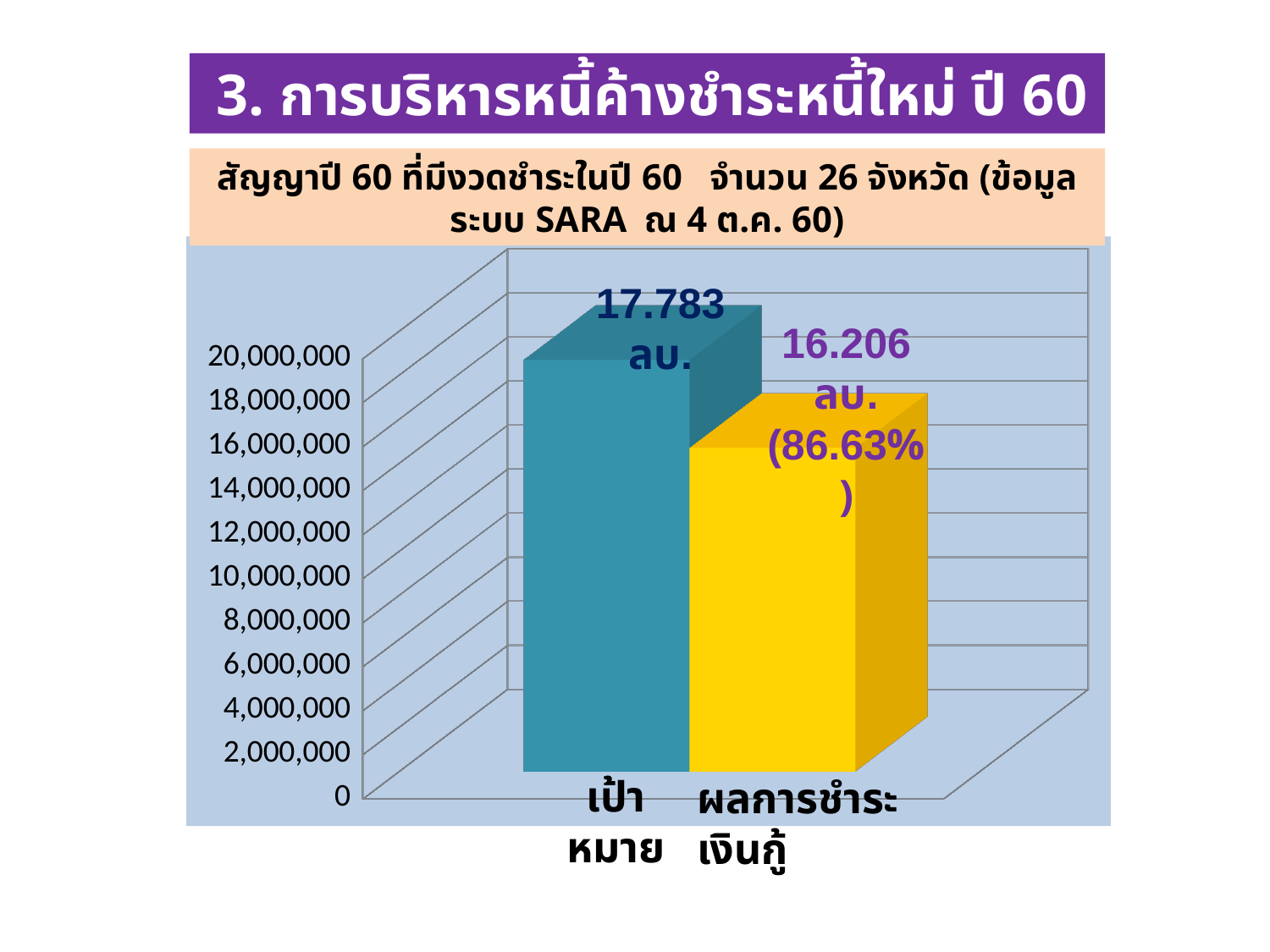
Is the value for ผลการชำระเงินกู้ greater or less than 18,000,000? less What is the value shown for เป้าหมาย? 17.783 ลบ. What percentage is shown next to the ผลการชำระเงินกู้ bar? 86.63% Is the value for เป้าหมาย greater or less than 16,000,000? greater How many bars are plotted in the chart? 2 What kind of chart is shown on the slide? Bar chart Which category has the highest value? เป้าหมาย What is the highest value labelled on the vertical axis? 20,000,000 Which category has the higher value, เป้าหมาย or ผลการชำระเงินกู้? เป้าหมาย What is the value shown for ผลการชำระเงินกู้? 16.206 ลบ. Which category has the lowest value? ผลการชำระเงินกู้ What is the difference between the เป้าหมาย value and the ผลการชำระเงินกู้ value? 1.577 ลบ.